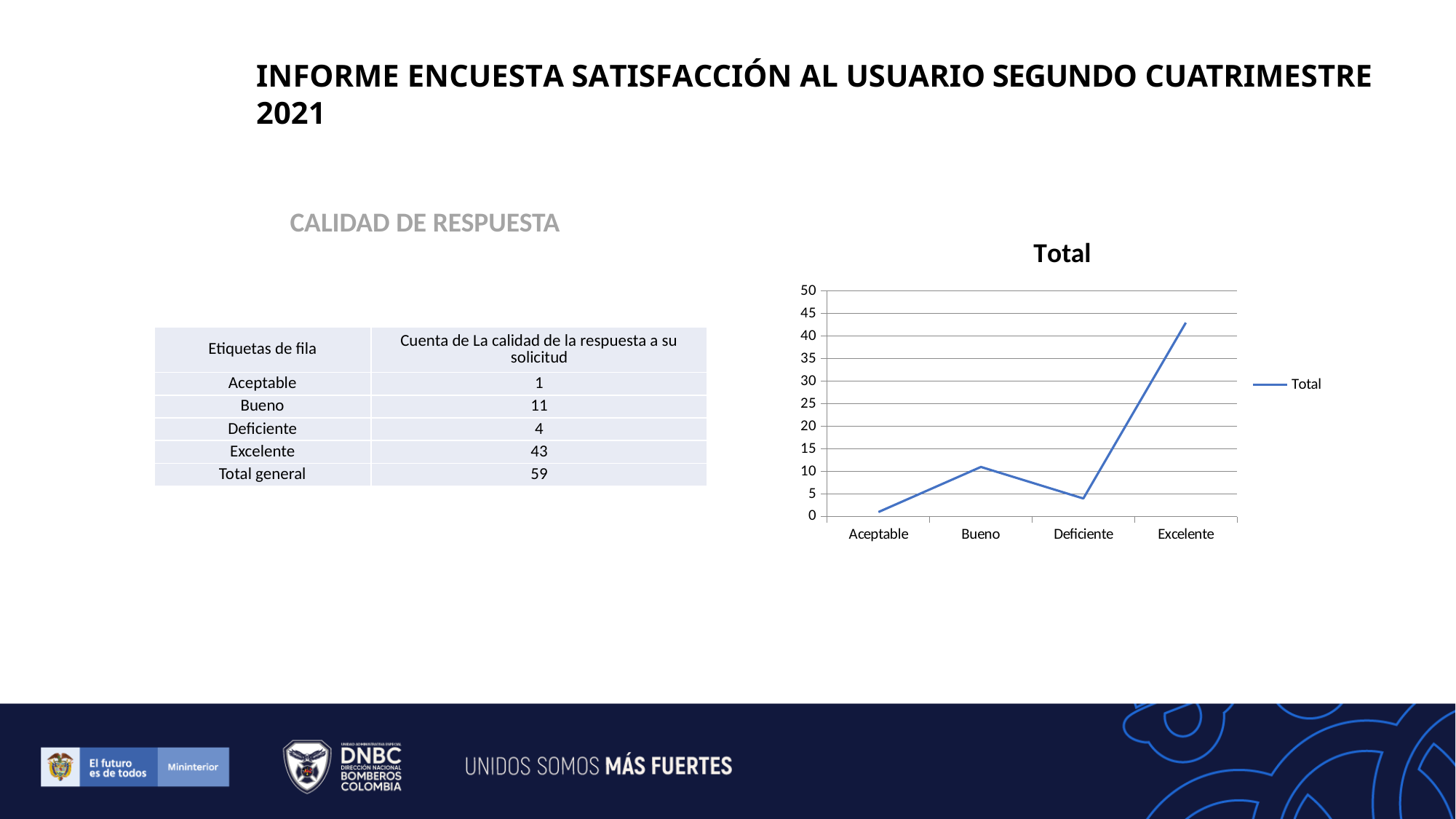
What is the difference between the values for Excelente and Bueno? 32 What is the title of the chart? Total What is the value for Excelente in the chart? 43 Is the value for Bueno greater or less than 10? greater How many categories are plotted along the x axis of the chart? 4 What kind of chart is shown on the slide? line chart Is the value for Deficiente greater or less than 5? less Which is larger, the value for Bueno or the value for Deficiente? Bueno How many series does the chart legend list? 1 Is the value for Excelente greater or less than 40? greater Which category has the highest value in the chart? Excelente Which category has the lowest value in the chart? Aceptable